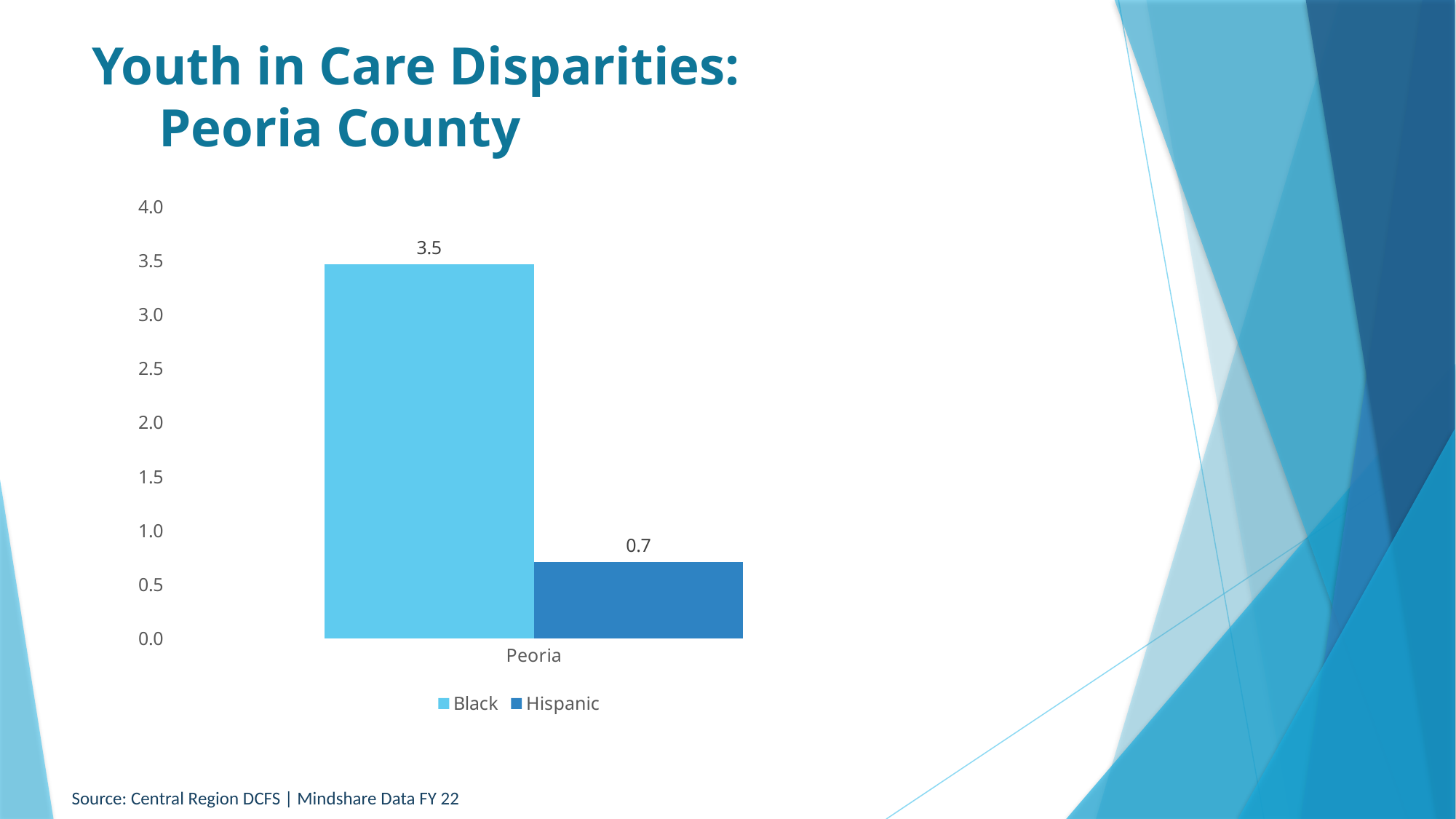
What is the value for Hispanic in Peoria? 0.7 How many categories are shown on the x axis? 1 Which series has the lowest value in the chart? Hispanic Is the value for Black in Peoria greater or less than 3.0? greater Which series has the higher value for Peoria, Black or Hispanic? Black What is the title of the slide? Youth in Care Disparities: Peoria County What is the difference between the Black and Hispanic values for Peoria? 2.8 Is the value for Hispanic in Peoria greater or less than 1.0? less How many series does the legend list? 2 What kind of chart is shown on the slide? Bar chart Which series has the highest value in the chart? Black What is the value for Black in Peoria? 3.5